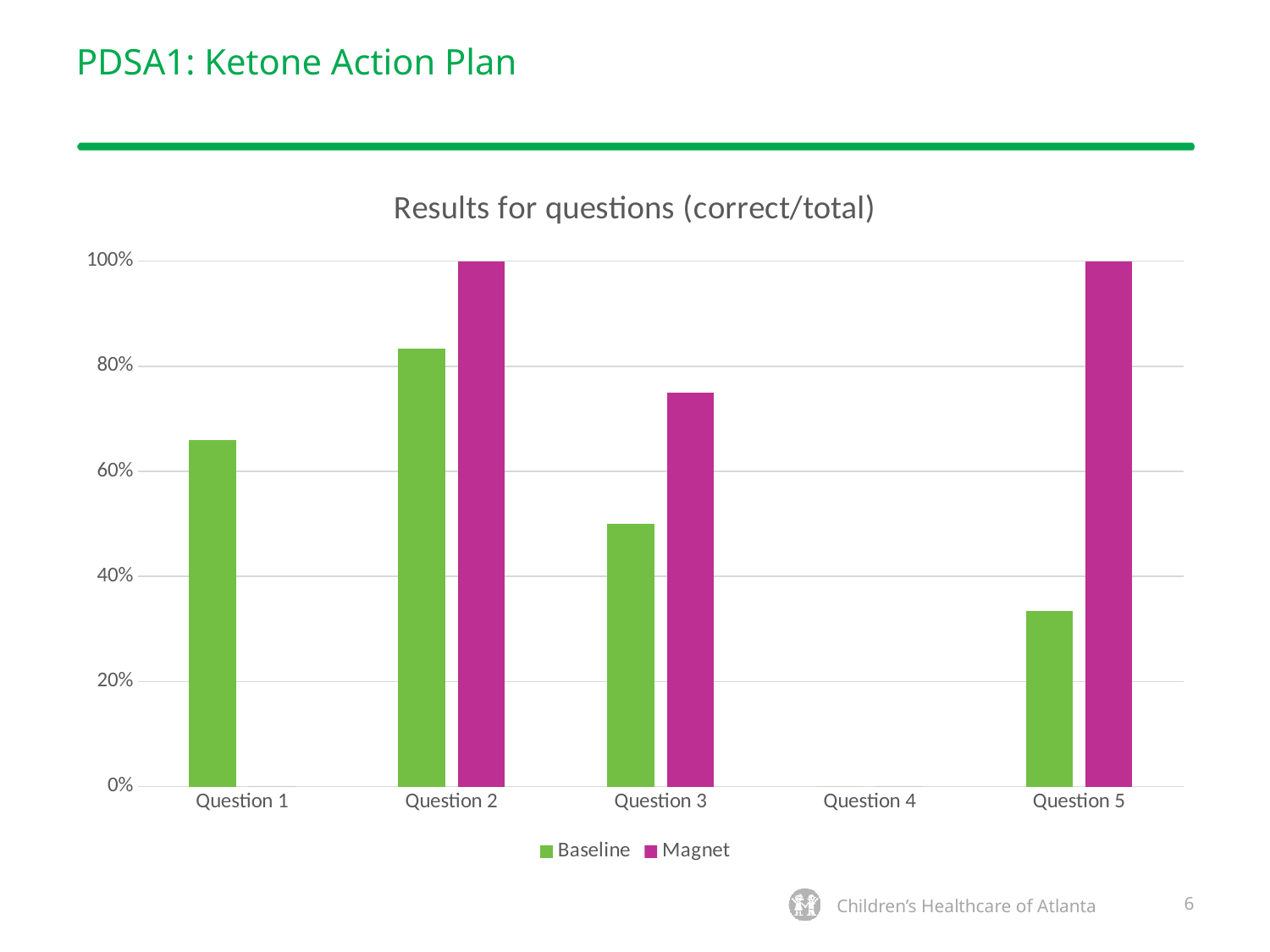
For Question 3, which is larger, the Baseline value or the Magnet value? Magnet Which question has the highest Baseline value? Question 2 Which question has the lowest Baseline value among those with a Baseline bar? Question 5 Is the Magnet value for Question 3 greater or less than 80%? less What is the Magnet value for Question 2? 100% Is the Baseline value for Question 1 greater or less than 60%? greater Is the Baseline value for Question 5 greater or less than 40%? less What kind of chart is shown on the slide? Bar chart How many question categories are shown on the x axis? 5 What is the title of the chart? Results for questions (correct/total) How many series does the legend list? 2 What is the Magnet value for Question 5? 100%